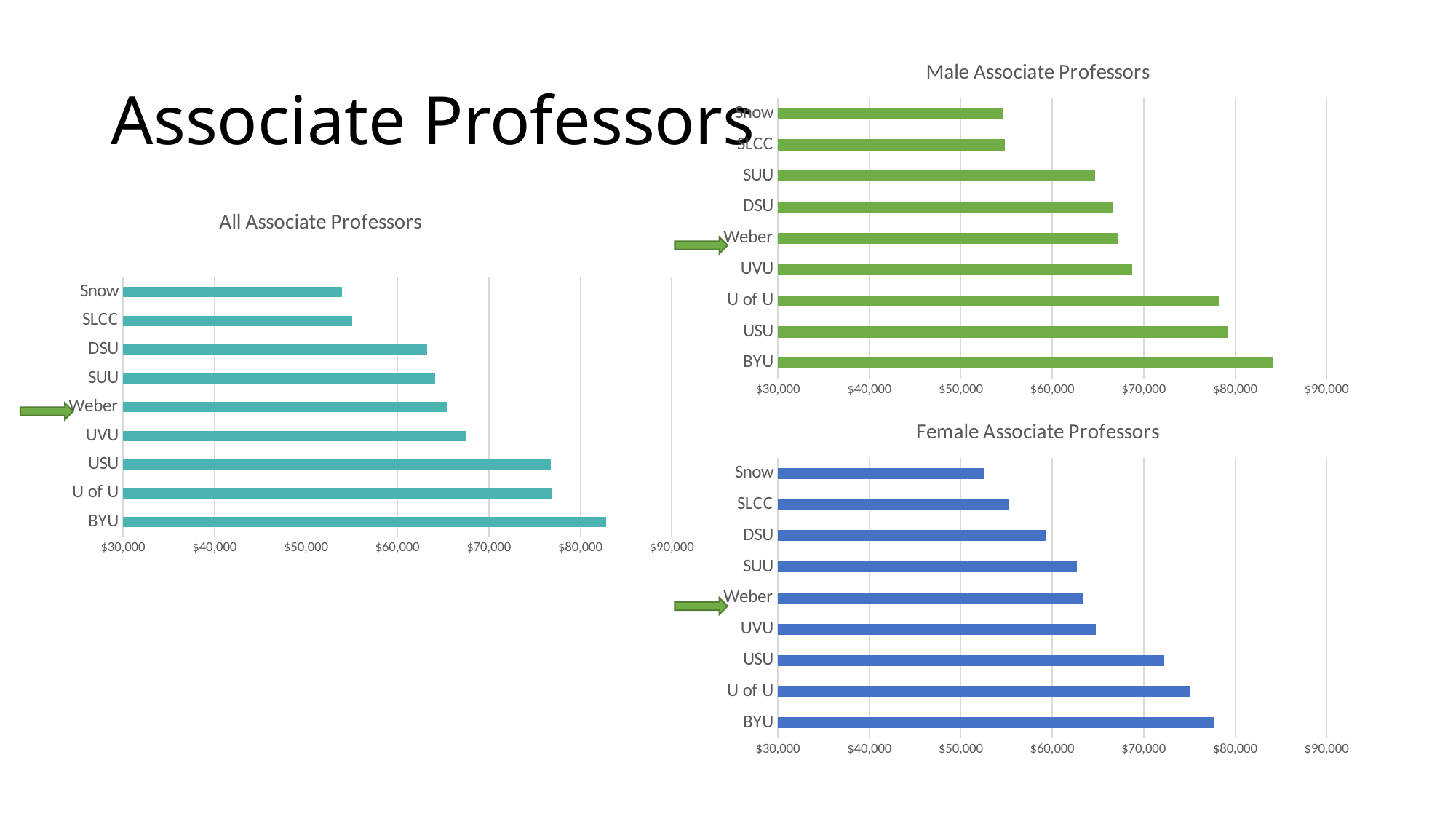
In the "All Associate Professors" chart, is the value for Weber greater or less than $60,000? greater In the "Female Associate Professors" chart, is the value for USU greater or less than $70,000? greater In the "Female Associate Professors" chart, which institution has the lowest value? Snow In the "Female Associate Professors" chart, is the value for Snow greater or less than $60,000? less How many institutions are shown in the "Male Associate Professors" chart? 9 How many charts are on the slide? 3 What kind of chart is the "All Associate Professors" chart? bar chart In the "Male Associate Professors" chart, which is larger, the value for SUU or the value for U of U? U of U In the "All Associate Professors" chart, which institution has the highest value? BYU In the "Male Associate Professors" chart, which institution has the highest value? BYU In the "All Associate Professors" chart, which institution has the lowest value? Snow